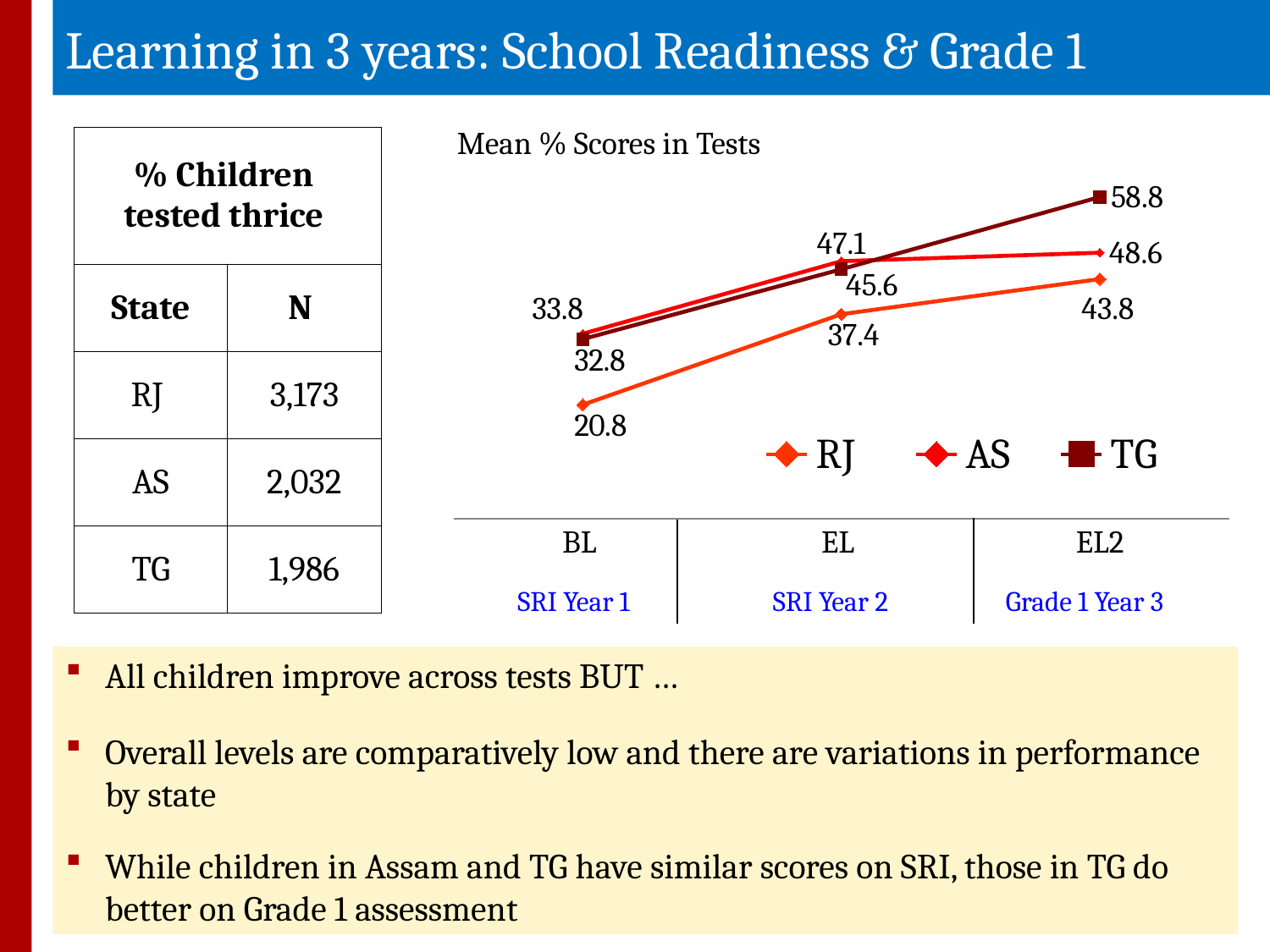
Which state has the highest mean % score at EL2? TG What is the difference between TG's and AS's mean % scores at EL2? 10.2 What is the mean % score for TG at EL? 45.6 What kind of chart is shown? Line chart Which state has the lowest mean % score at BL? RJ What is the mean % score for AS at EL? 47.1 What is the mean % score for TG at EL2? 58.8 What is the mean % score for RJ at BL? 20.8 What is the difference between RJ's scores at EL2 and BL? 23 How many series does the legend list? 3 Do the scores for RJ rise or fall from BL to EL2? Rise Which is larger at EL: the score for AS or the score for RJ? AS